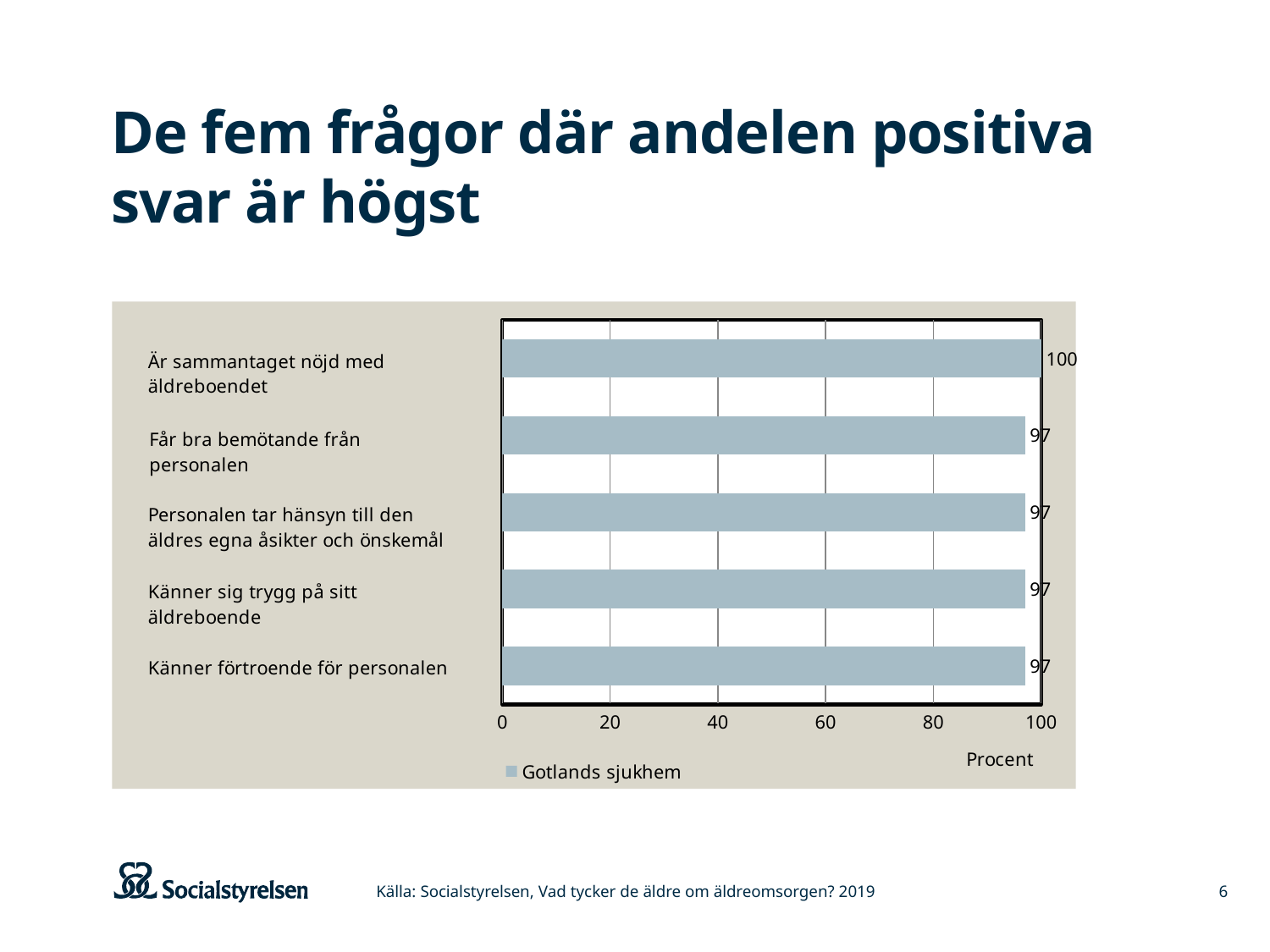
What is the name of the series shown in the legend? Gotlands sjukhem Is the value for "Känner sig trygg på sitt äldreboende" greater or less than 80? greater What kind of chart is shown on the slide? bar chart What is the value for "Känner förtroende för personalen"? 97 Which is larger: the value for "Är sammantaget nöjd med äldreboendet" or the value for "Känner förtroende för personalen"? Är sammantaget nöjd med äldreboendet What is the value for "Är sammantaget nöjd med äldreboendet"? 100 What is the difference between the values for "Är sammantaget nöjd med äldreboendet" and "Personalen tar hänsyn till den äldres egna åsikter och önskemål"? 3 Which category has the highest value? Är sammantaget nöjd med äldreboendet What is the value for "Får bra bemötande från personalen"? 97 What is the value for "Känner sig trygg på sitt äldreboende"? 97 How many categories are shown in the chart? 5 How many series does the legend list? 1